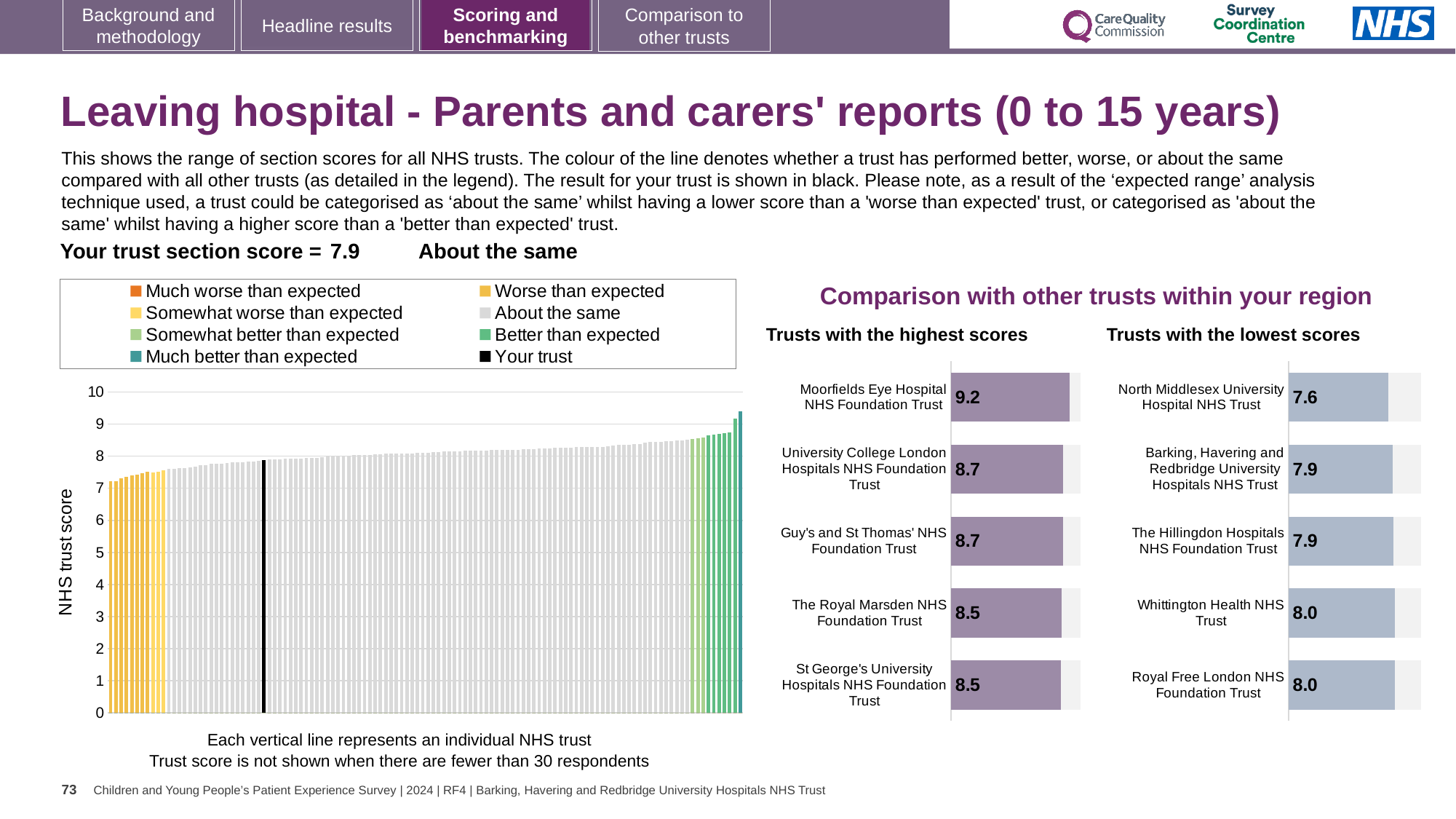
In the 'Trusts with the highest scores' chart, what is the difference between the scores of Moorfields Eye Hospital NHS Foundation Trust and The Royal Marsden NHS Foundation Trust? 0.7 In the 'Trusts with the lowest scores' chart, what is the difference between the scores of Royal Free London NHS Foundation Trust and North Middlesex University Hospital NHS Trust? 0.4 In the 'Trusts with the highest scores' chart, what is the score for The Royal Marsden NHS Foundation Trust? 8.5 In the 'Trusts with the lowest scores' chart, what is the score for North Middlesex University Hospital NHS Trust? 7.6 Which is larger: the score for Guy's and St Thomas' NHS Foundation Trust in the 'Trusts with the highest scores' chart or the score for The Hillingdon Hospitals NHS Foundation Trust in the 'Trusts with the lowest scores' chart? Guy's and St Thomas' NHS Foundation Trust In the 'Trusts with the highest scores' chart, which trust has the highest score? Moorfields Eye Hospital NHS Foundation Trust In the large chart on the left showing the range of section scores, do the trust scores rise or fall from left to right? rise How many trusts are shown in the 'Trusts with the highest scores' chart? 5 How many entries does the legend of the large chart on the left list? 8 In the 'Trusts with the lowest scores' chart, what is the score for Whittington Health NHS Trust? 8.0 In the 'Trusts with the highest scores' chart, what is the score for Moorfields Eye Hospital NHS Foundation Trust? 9.2 In the 'Trusts with the lowest scores' chart, which trust has the lowest score? North Middlesex University Hospital NHS Trust